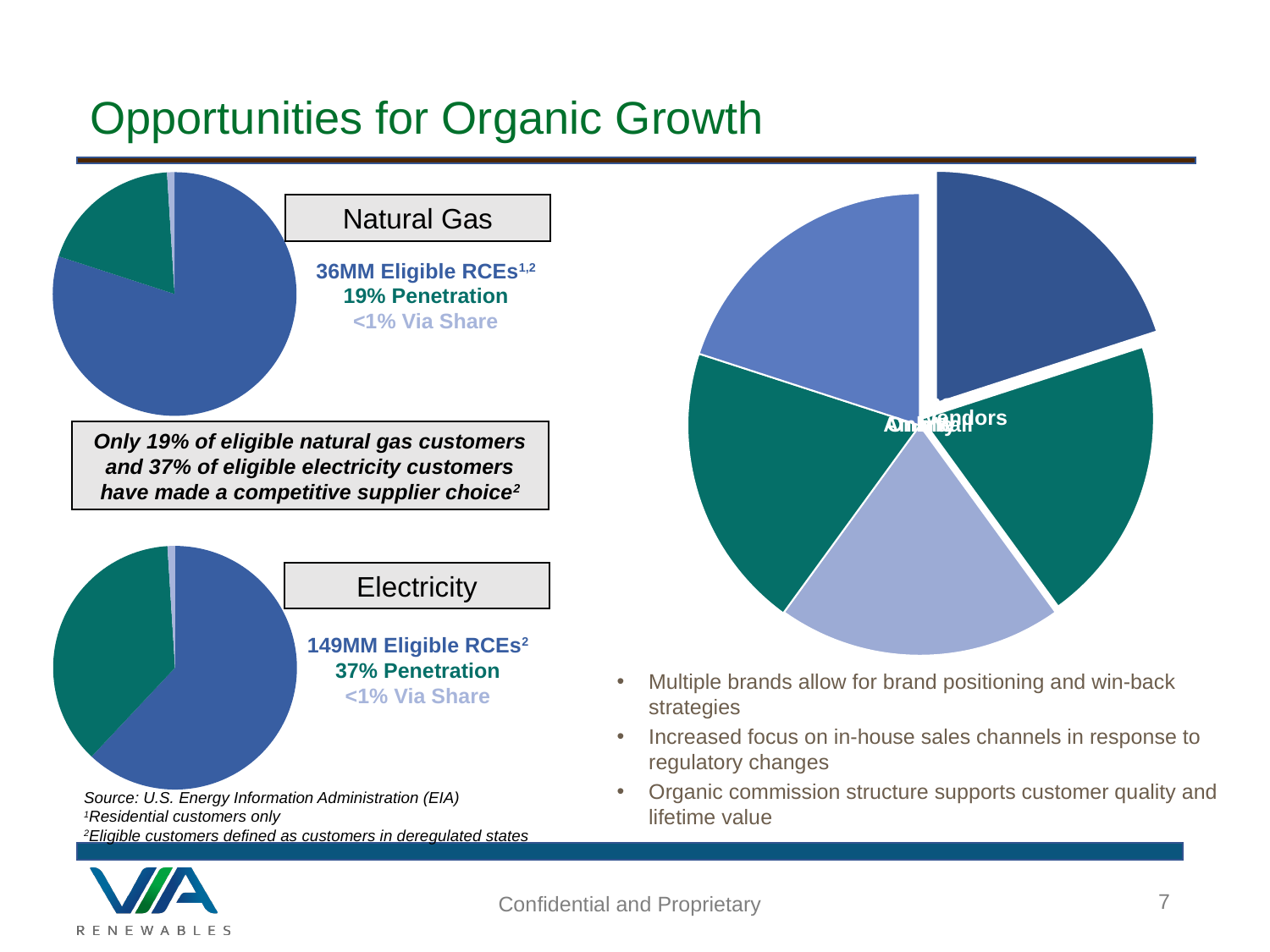
How many slices does the large pie chart on the right side of the slide have? 5 On the Natural Gas chart, what Via share is shown? <1% How many slices does the Natural Gas pie chart have? 3 What is the difference in penetration between the Electricity chart and the Natural Gas chart? 18% On the Electricity chart, how many eligible RCEs are shown? 149MM On the Natural Gas chart, how many eligible RCEs are shown? 36MM Which has the higher penetration, Natural Gas or Electricity? Electricity On the Natural Gas chart, what is the penetration percentage shown? 19% On the Electricity chart, what is the penetration percentage shown? 37% On the Electricity chart, what Via share is shown? <1% What kind of chart is the large chart on the right side of the slide? pie chart What kind of chart is the Natural Gas chart on the left of the slide? pie chart